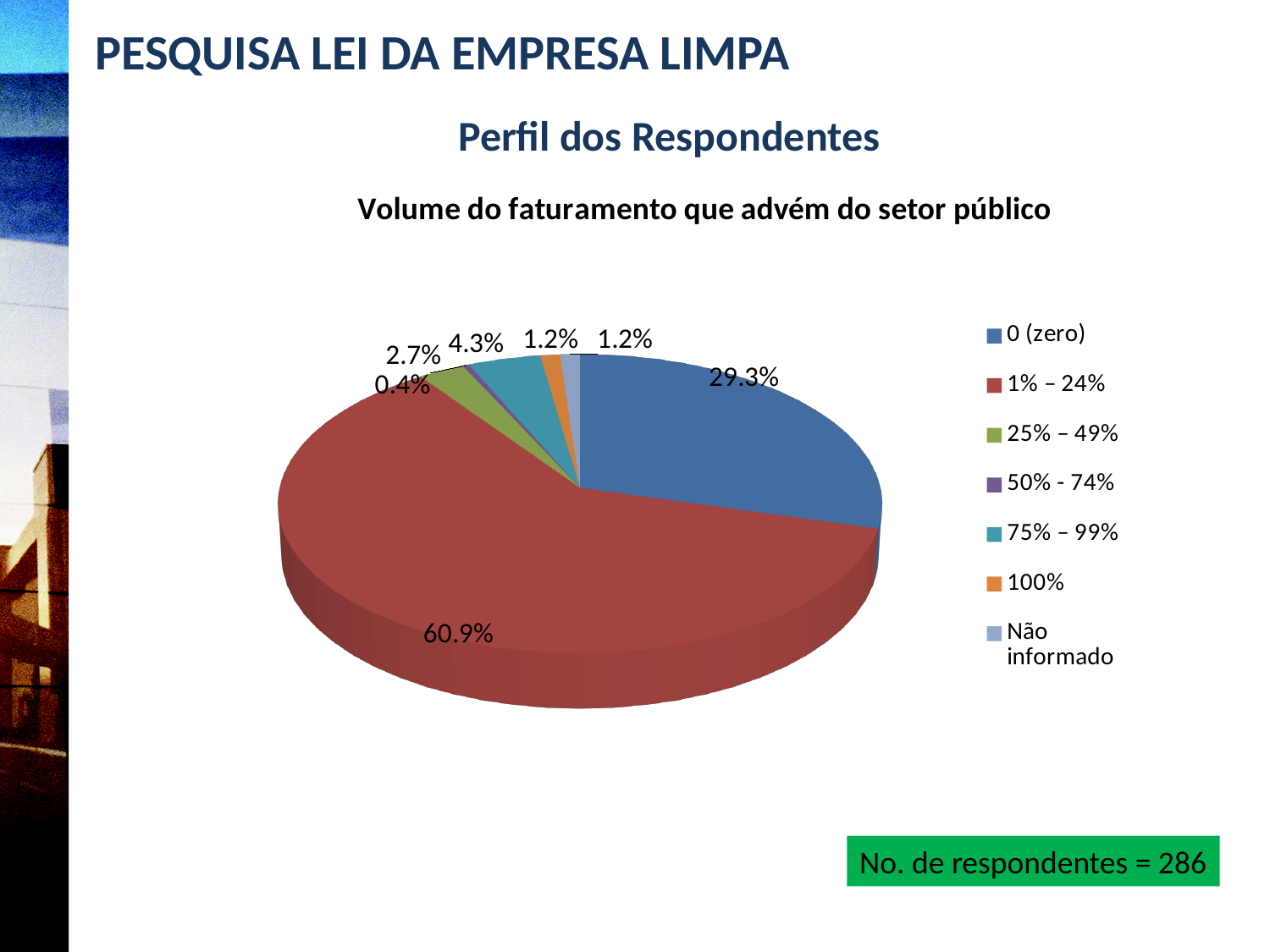
Which is larger, the share for '75% – 99%' or the share for '25% – 49%'? 75% – 99% What share of the pie does the '1% – 24%' category have? 60.9% What share of the pie does the '75% – 99%' category have? 4.3% What is the difference between the shares of '1% – 24%' and '0 (zero)'? 31.6% Which category has the largest slice of the pie? 1% – 24% What share of the pie does the '0 (zero)' category have? 29.3% How many categories does the legend of the pie chart list? 7 What type of chart is shown on the slide? pie chart What is the title of the chart? Volume do faturamento que advém do setor público Which category has the smallest slice of the pie? 50% - 74%